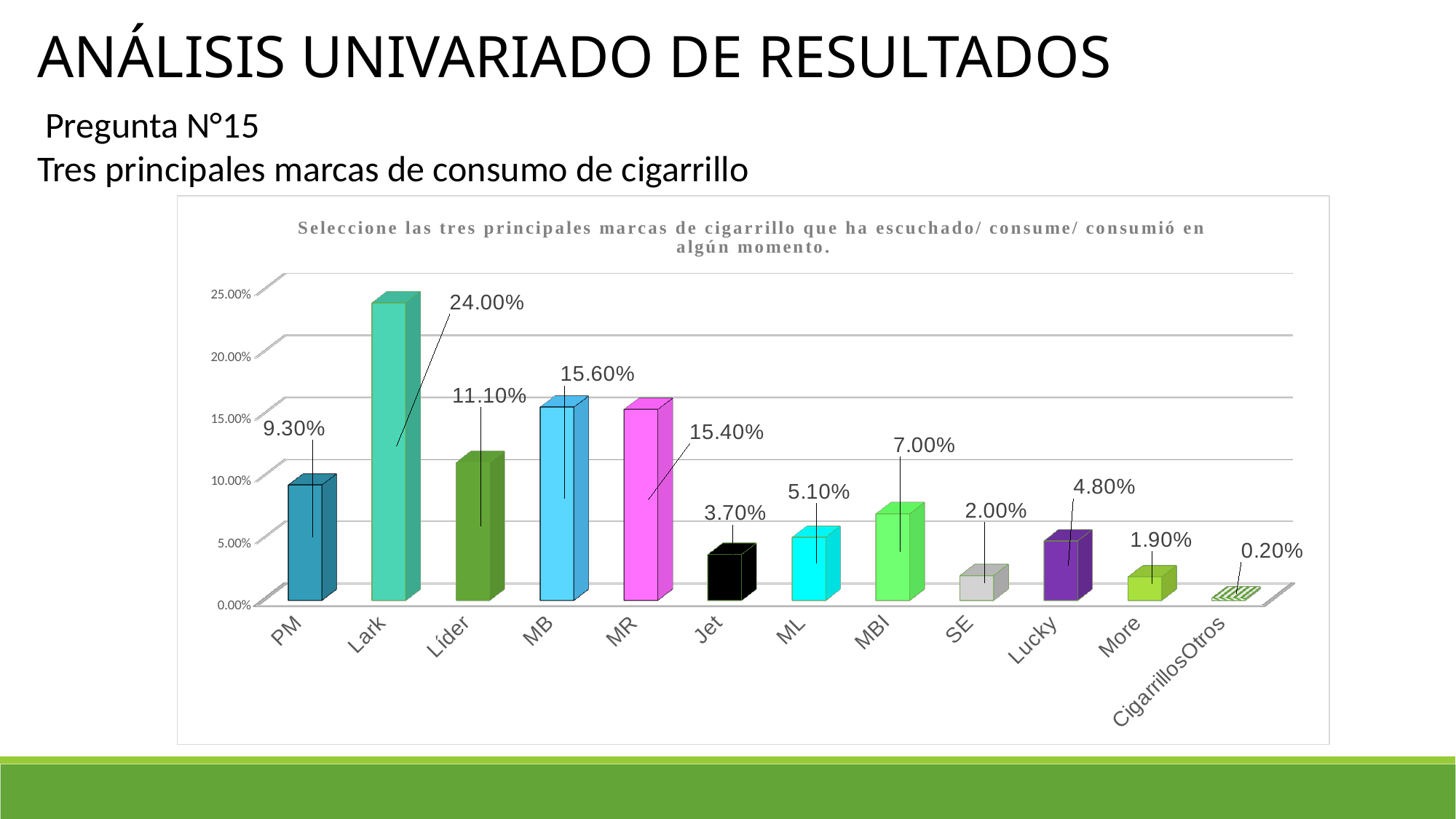
Which brand has the lowest value? CigarrillosOtros Is the value for PM greater or less than 10.00%? less What is the difference between the values for Lark and PM? 14.70% How many brands are shown on the x axis? 12 What is the value for MBI? 7.00% What is the value for Lark? 24.00% Which is larger, the value for Líder or the value for Jet? Líder What is the value for Lucky? 4.80% What kind of chart is shown on the slide? bar chart Which brand has the highest value? Lark What is the difference between the values for MB and MR? 0.20% What is the value for CigarrillosOtros? 0.20%